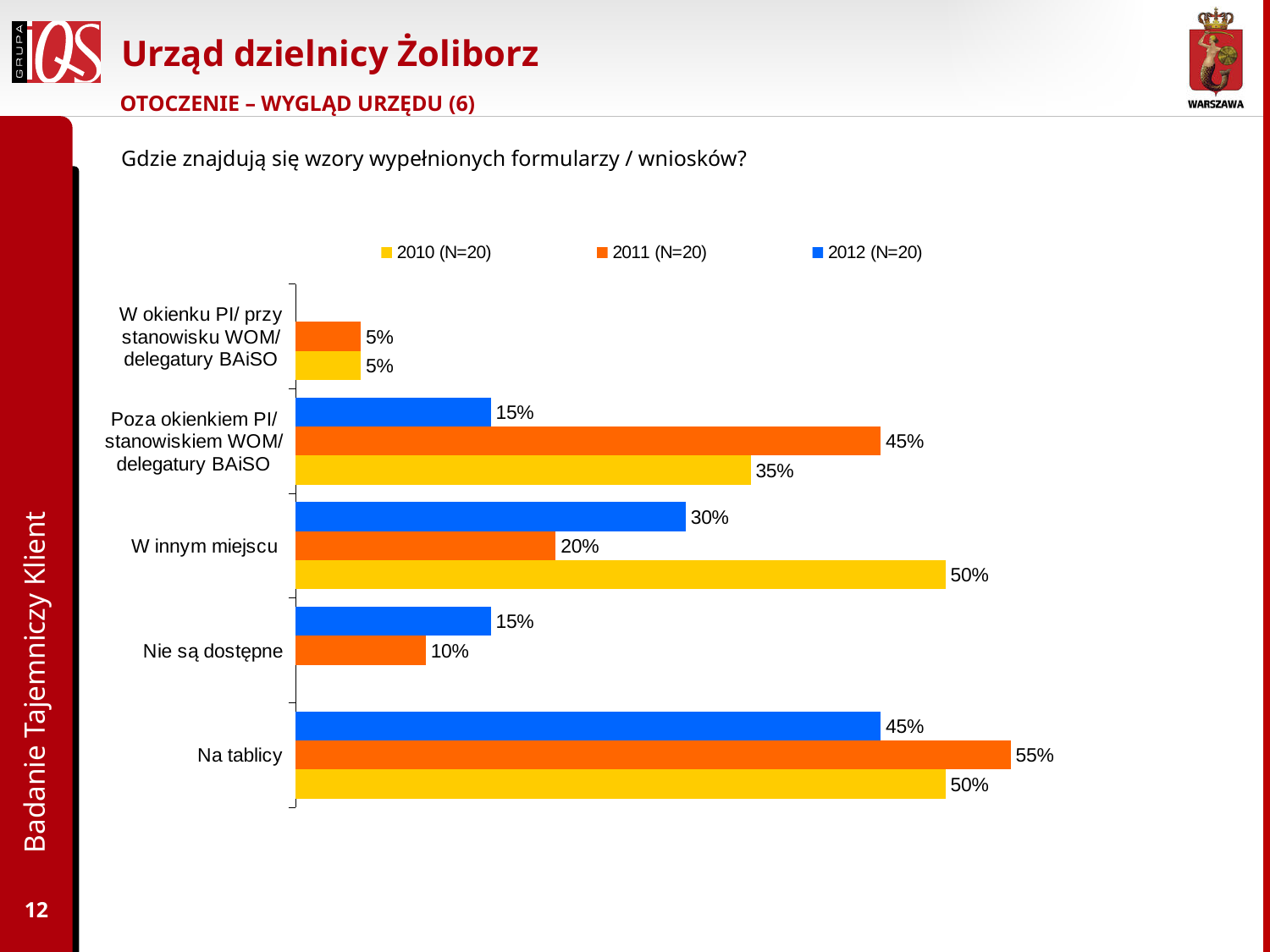
What is the value for 'Na tablicy' in the 2011 (N=20) series? 55% How many categories are shown on the chart? 5 Which category has the highest value in the 2012 (N=20) series? Na tablicy For 'W innym miejscu', which series has the larger value: 2012 (N=20) or 2011 (N=20)? 2012 (N=20) What is the value for 'Poza okienkiem PI/ stanowiskiem WOM/ delegatury BAiSO' in the 2012 (N=20) series? 15% What is the difference between the 2011 (N=20) and 2010 (N=20) values for 'Poza okienkiem PI/ stanowiskiem WOM/ delegatury BAiSO'? 10% What is the value for 'W innym miejscu' in the 2010 (N=20) series? 50% What kind of chart is shown on the slide? bar chart Which colour represents the 2012 (N=20) series in the legend? blue Which category has the lowest value in the 2010 (N=20) series? W okienku PI/ przy stanowisku WOM/ delegatury BAiSO How many series does the legend list? 3 What is the value for 'Nie są dostępne' in the 2011 (N=20) series? 10%